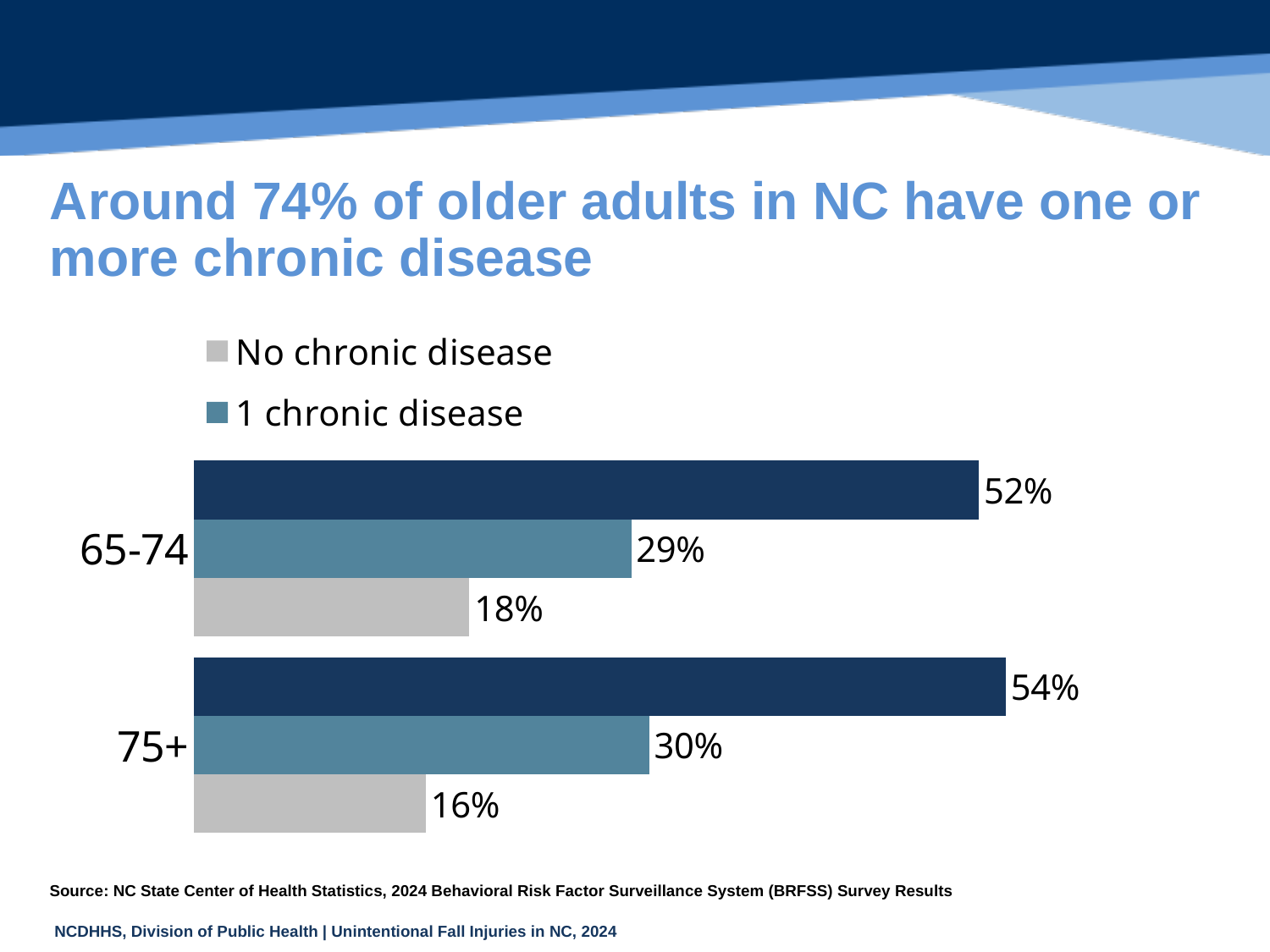
How many age groups are shown on the chart? 2 How many series does the legend list? 2 What is the value for No chronic disease in the 75+ age group? 16% What is the value for 1 chronic disease in the 75+ age group? 30% What colour represents No chronic disease in the legend? Grey What is the difference between the No chronic disease values for 65-74 and 75+? 2% What is the value for 1 chronic disease in the 65-74 age group? 29% Which age group has the higher value for No chronic disease, 65-74 or 75+? 65-74 What kind of chart is shown on the slide? Bar chart Which age group has the higher value for 1 chronic disease? 75+ What is the difference between the 1 chronic disease values for 75+ and 65-74? 1% What is the value for No chronic disease in the 65-74 age group? 18%